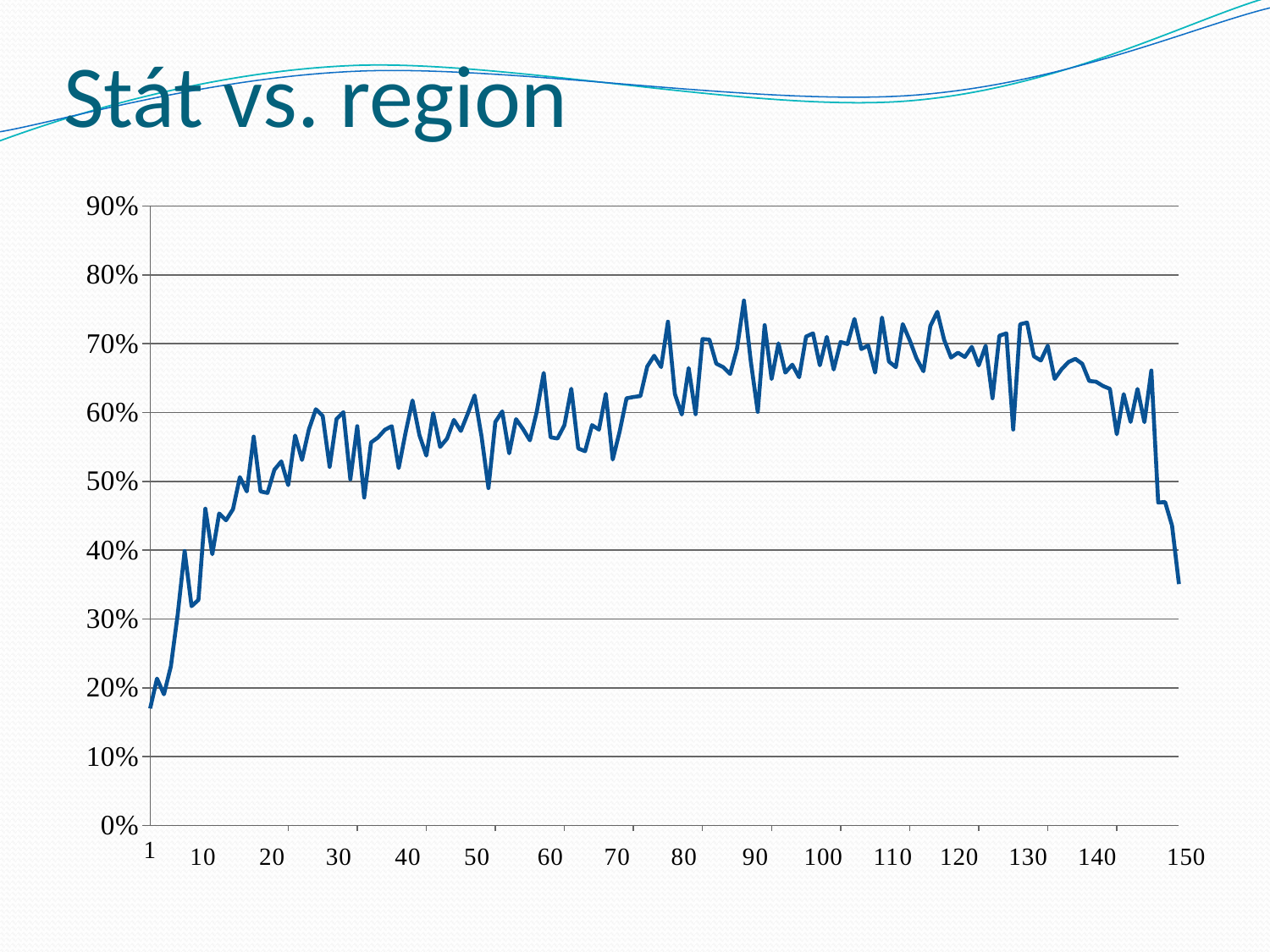
Is the value at x = 150 greater or less than 40%? less What is the highest value labelled on the y axis? 90% What is the title of the chart? Stát vs. region What kind of chart is shown on the slide? line chart Is the value at x = 1 greater or less than 20%? less Do the values rise or fall between x = 145 and x = 150? fall Is the lowest point on the line greater or less than 20%? less Which is larger, the value at x = 1 or the value at x = 100? x = 100 Do the values generally rise or fall between x = 1 and x = 30? rise